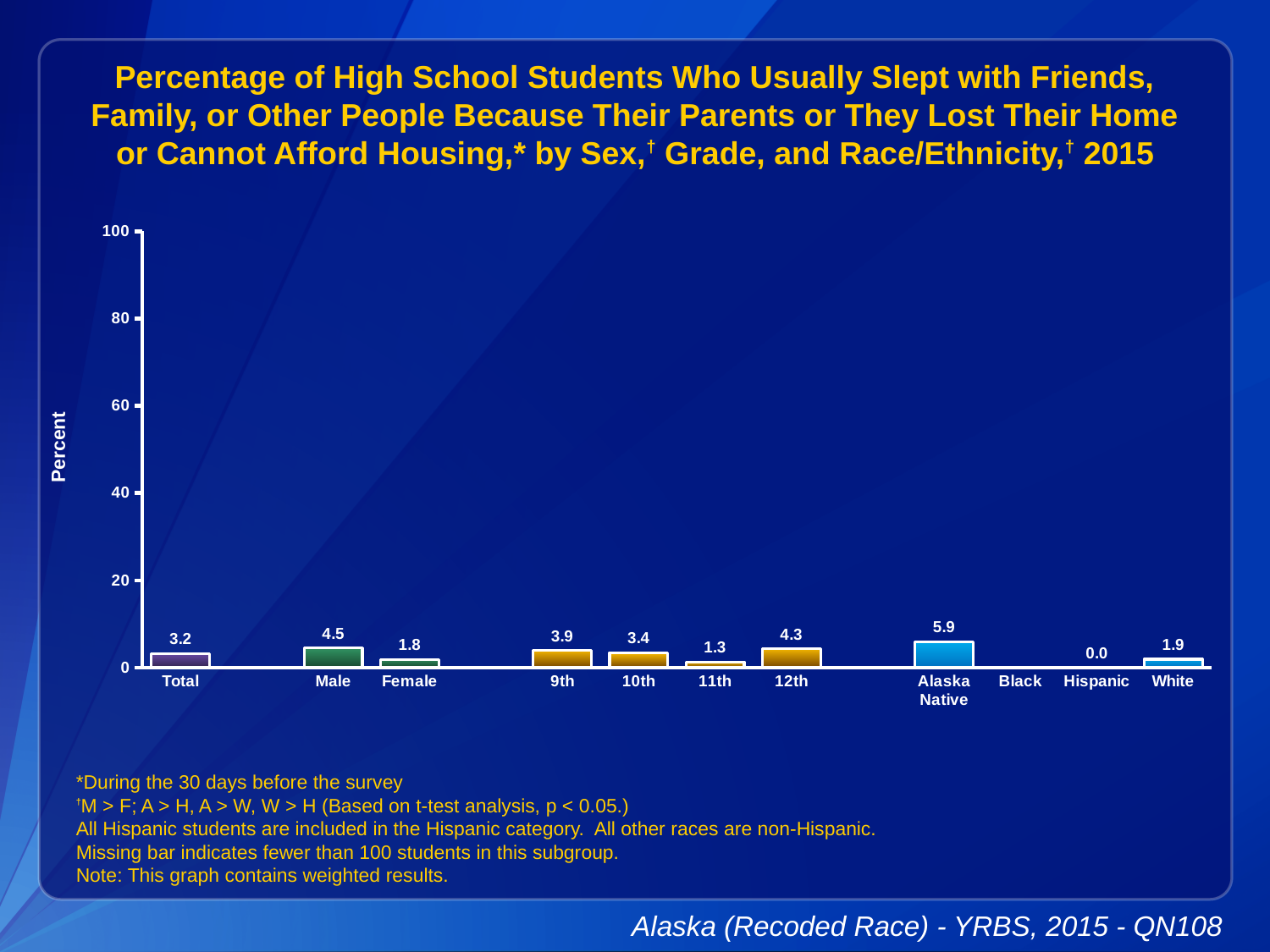
What is the value for Male? 4.5 Which is larger, the value for 9th grade or the value for 10th grade? 9th What is the value for Alaska Native? 5.9 What kind of chart is shown on the slide? bar chart What is the value for Hispanic? 0.0 What is the label of the y axis? Percent How many categories are labeled on the x axis? 11 Is the value for Total greater or less than 20? less Which category has the highest value? Alaska Native What is the value for 11th grade? 1.3 Among the grade categories (9th, 10th, 11th, 12th), which has the lowest value? 11th What is the difference between the values for Male and Female? 2.7